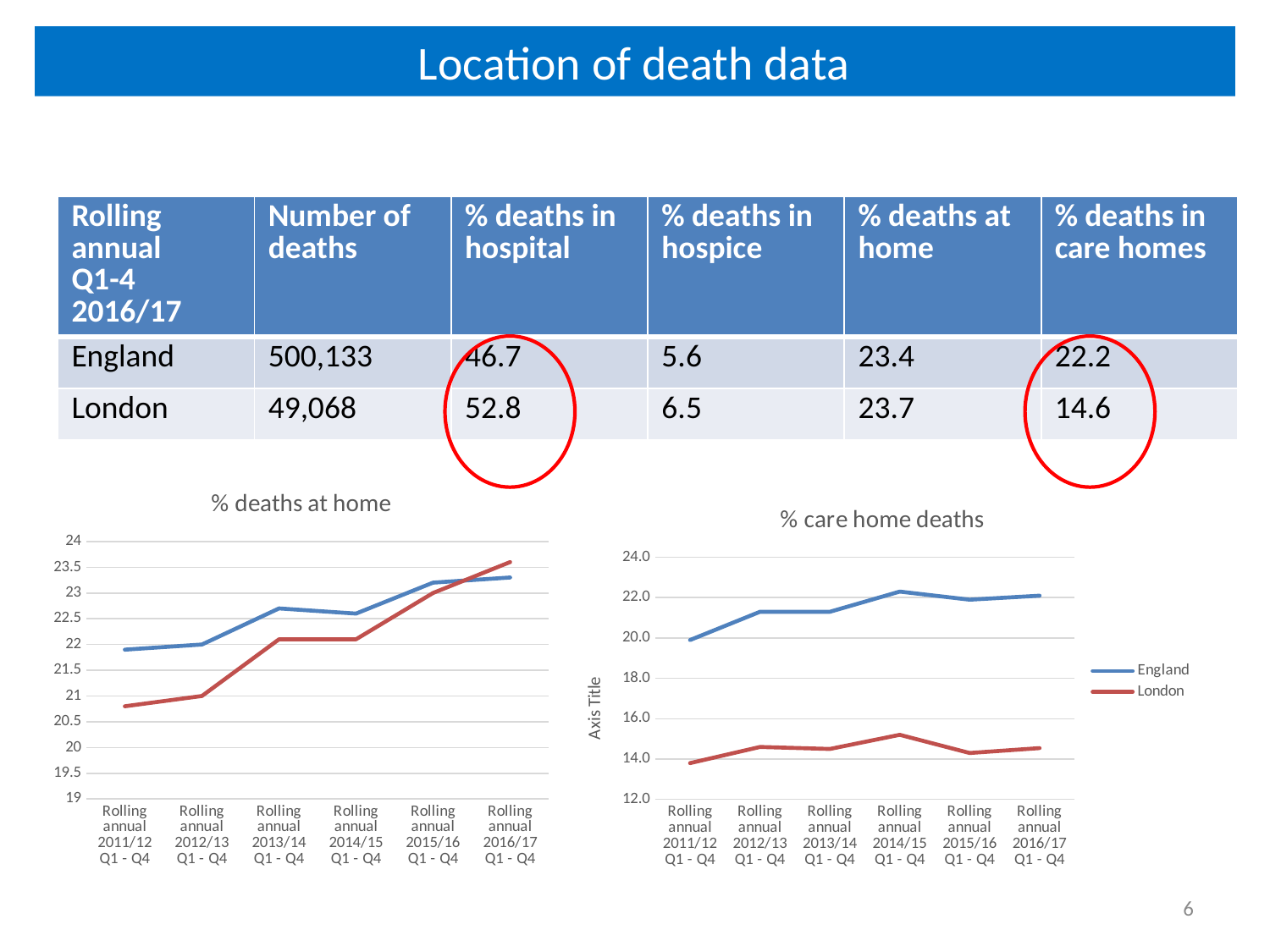
How many rolling annual periods are plotted on the x axis of the '% care home deaths' chart? 6 In the '% care home deaths' chart, is the England value for Rolling annual 2012/13 Q1 - Q4 greater or less than 20.0? greater In the '% care home deaths' chart, does the England line rise or fall from Rolling annual 2011/12 Q1 - Q4 to Rolling annual 2014/15 Q1 - Q4? rise In the '% deaths at home' chart, is the red line's value for Rolling annual 2011/12 Q1 - Q4 greater or less than 21? less How many series does the legend of the '% care home deaths' chart list? 2 What is the title of the chart on the left of the slide? % deaths at home In the '% care home deaths' chart, is the London value for Rolling annual 2014/15 Q1 - Q4 greater or less than 16.0? less In the '% care home deaths' chart, which series is higher in Rolling annual 2016/17 Q1 - Q4, England or London? England In the '% care home deaths' chart, in which period is the England value lowest? Rolling annual 2011/12 Q1 - Q4 In the '% deaths at home' chart, which line is higher in Rolling annual 2016/17 Q1 - Q4, the red line or the blue line? the red line In the '% deaths at home' chart, does the red line rise or fall overall from Rolling annual 2011/12 Q1 - Q4 to Rolling annual 2016/17 Q1 - Q4? rise What type of chart is the '% care home deaths' chart? line chart